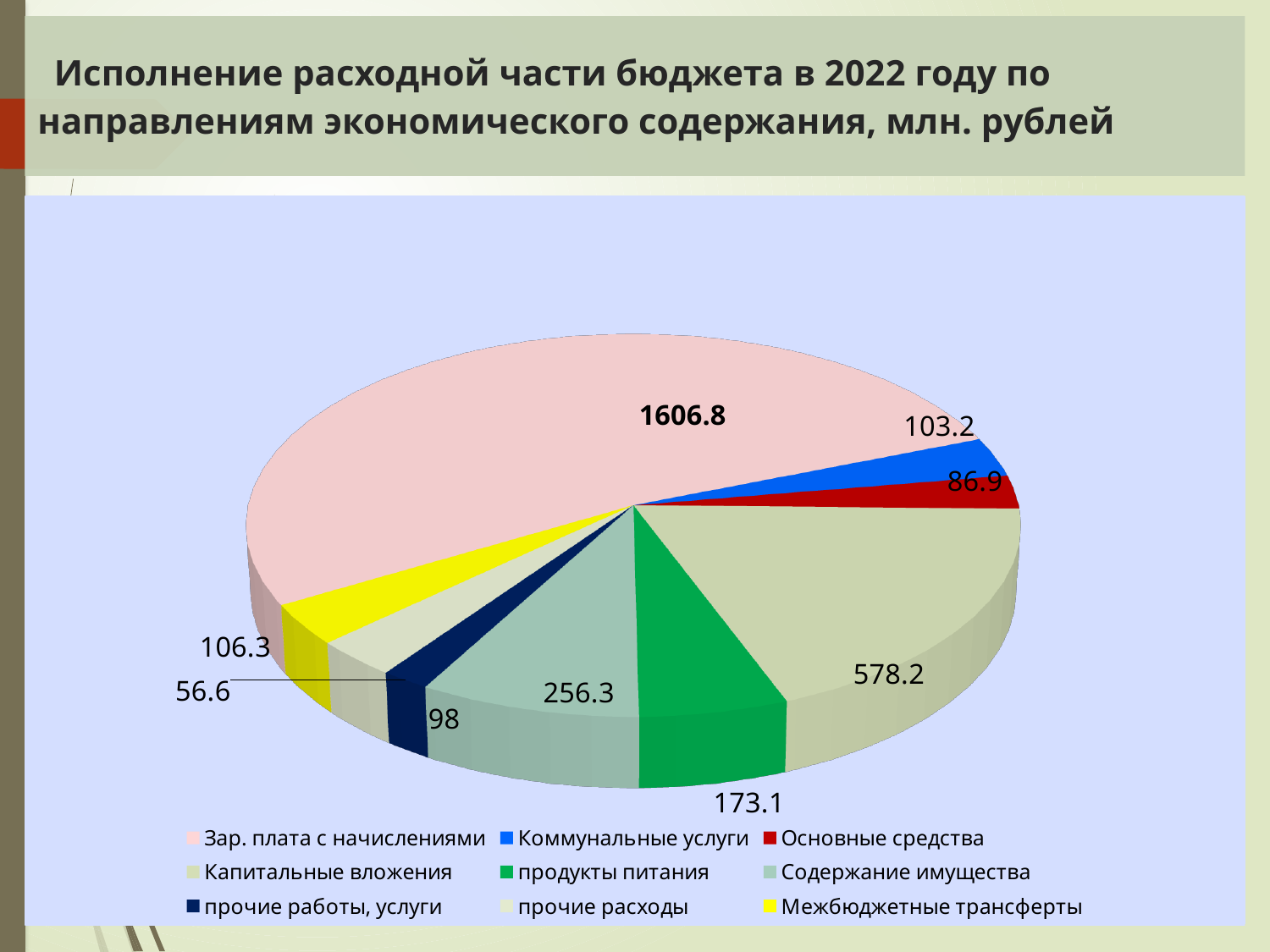
What is the value for Содержание имущества? 256.3 Which category has the largest slice of the pie? Зар. плата с начислениями What unit of measurement is stated in the chart title? млн. рублей What is the value for Коммунальные услуги? 103.2 Which category has the smallest slice of the pie? прочие работы, услуги What kind of chart is shown on the slide? pie chart What is the difference between the values for Капитальные вложения and продукты питания? 405.1 What is the value for прочие работы, услуги? 56.6 What is the value for Капитальные вложения? 578.2 Which is larger, the value for Межбюджетные трансферты or the value for Основные средства? Межбюджетные трансферты What is the value for Зар. плата с начислениями? 1606.8 How many slices does the pie chart have? 9